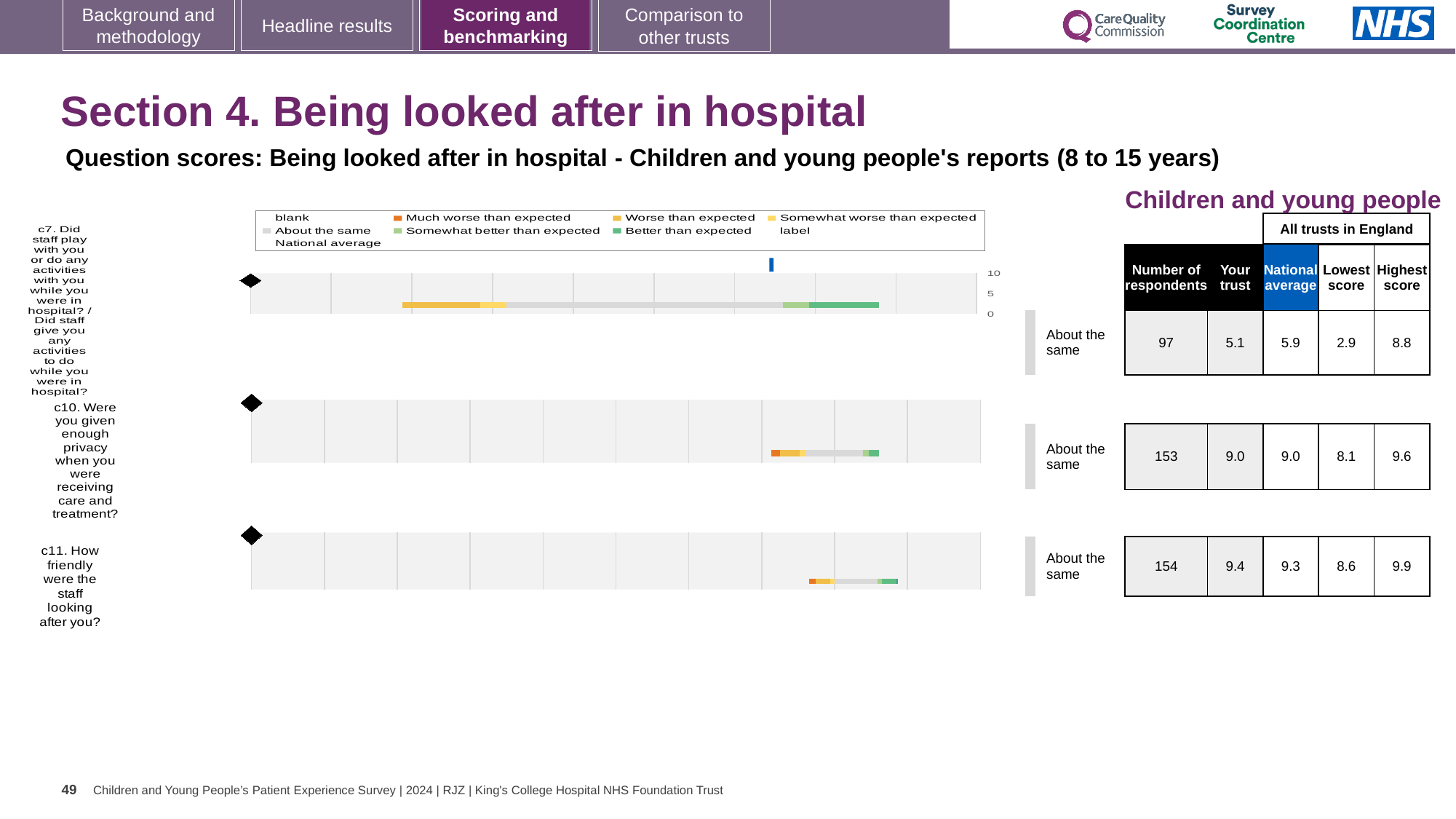
What is the national average score for question c7 (Did staff play with you or do any activities with you while you were in hospital?)? 5.9 What is the difference between the national average and the 'Your trust' score for question c7? 0.8 How many respondents answered question c11? 154 What is the 'Your trust' score for question c10 (Were you given enough privacy when you were receiving care and treatment?)? 9.0 What is the 'Your trust' score for question c11 (How friendly were the staff looking after you?)? 9.4 What benchmark category is shown for question c11? About the same Which question has the lowest 'Your trust' score? c7. Did staff play with you or do any activities with you while you were in hospital? Which question has the highest 'Your trust' score? c11. How friendly were the staff looking after you? What kind of chart is used to show the question scores on this slide? bar chart For question c7, which is larger: the 'Your trust' score or the national average? National average What is the lowest score across all trusts in England for question c10? 8.1 How many questions (chart rows) are plotted on the slide? 3